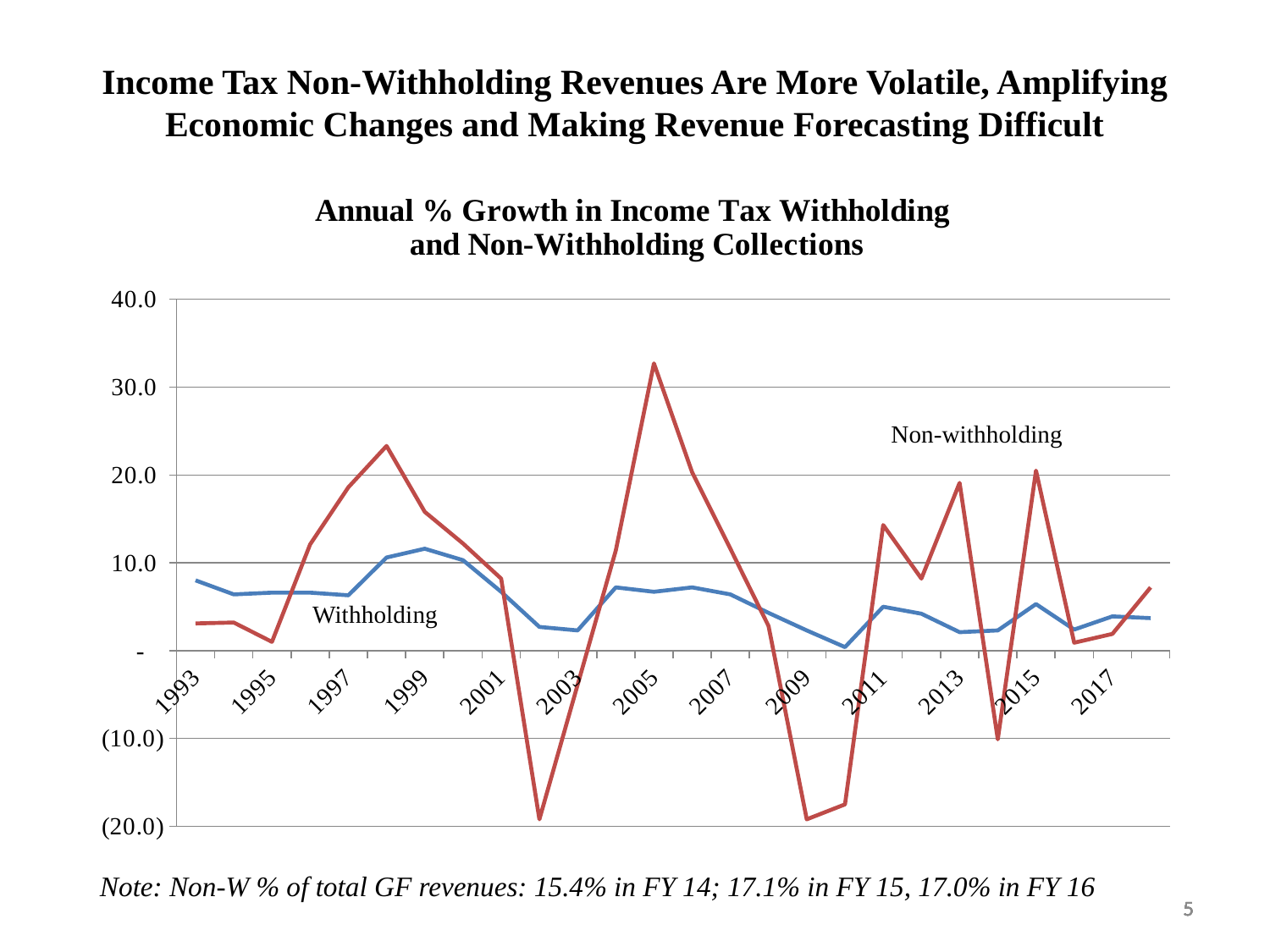
Does the Non-withholding series rise or fall between 2005 and 2009? fall Is the Non-withholding value in 2002 greater or less than (10.0)? less How many data series are plotted on the chart? 2 Is the Non-withholding value in 2005 greater or less than 30.0? greater Which series has the larger value in 2005, Withholding or Non-withholding? Non-withholding Is the Withholding value in 2005 greater or less than 10.0? less How many year labels are shown on the x axis? 13 Which series is drawn in red? Non-withholding What is the title of the chart? Annual % Growth in Income Tax Withholding and Non-Withholding Collections In which year does the Non-withholding series reach its highest value? 2005 What kind of chart is shown on the slide? line chart